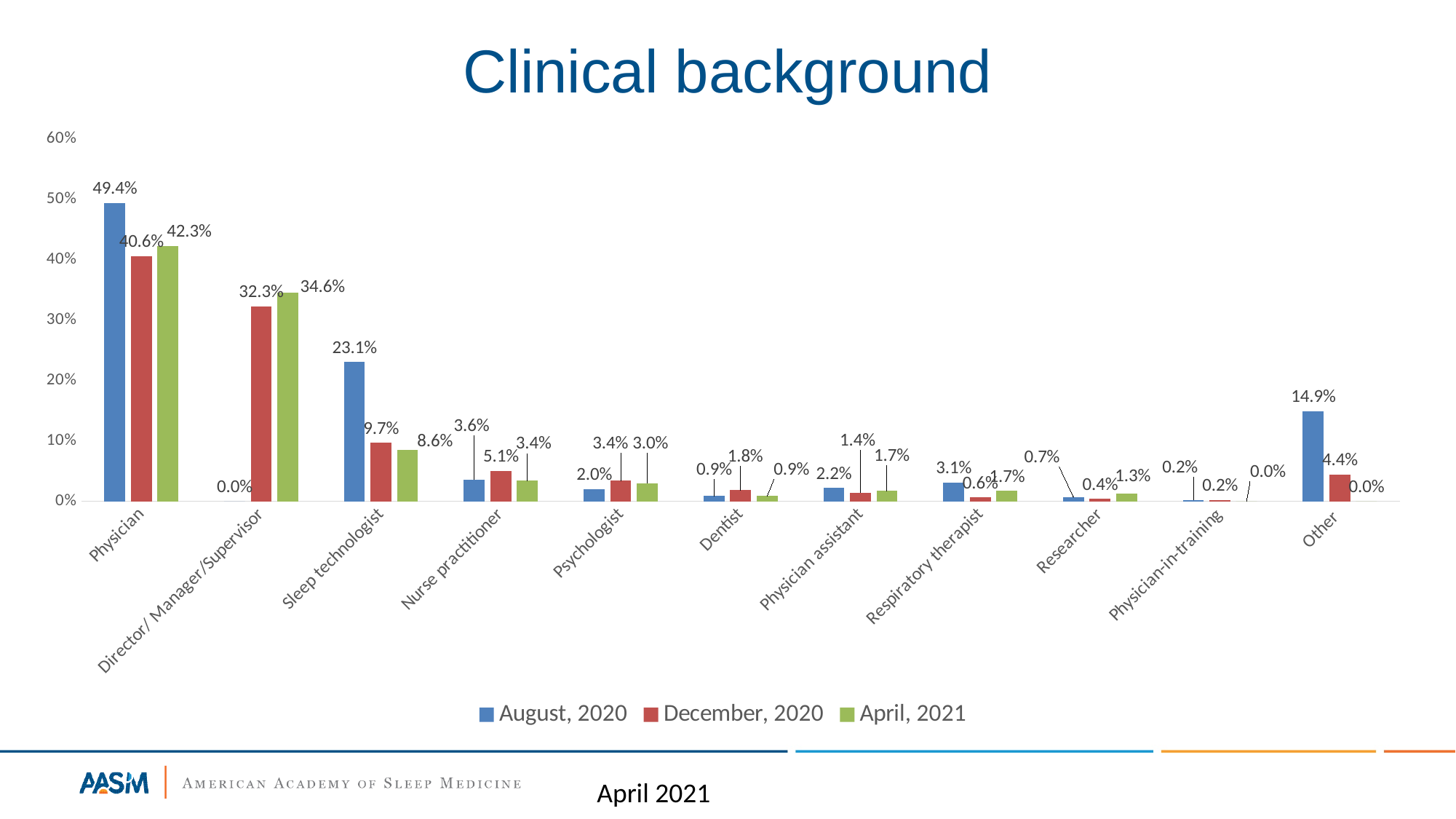
What is the value for Director/ Manager/Supervisor in the April, 2021 series? 34.6% Which category has the highest value in the August, 2020 series? Physician What is the value for Sleep technologist in the December, 2020 series? 9.7% What kind of chart is shown on the slide? Bar chart Which is larger for Physician: the December, 2020 value or the April, 2021 value? April, 2021 How many categories are shown on the x axis? 11 What is the value for Other in the August, 2020 series? 14.9% Which category has the lowest value in the August, 2020 series? Director/ Manager/Supervisor What is the value for Physician in the August, 2020 series? 49.4% How many series does the legend list? 3 What is the title of the chart? Clinical background What is the difference between the August, 2020 and April, 2021 values for Sleep technologist? 14.5%